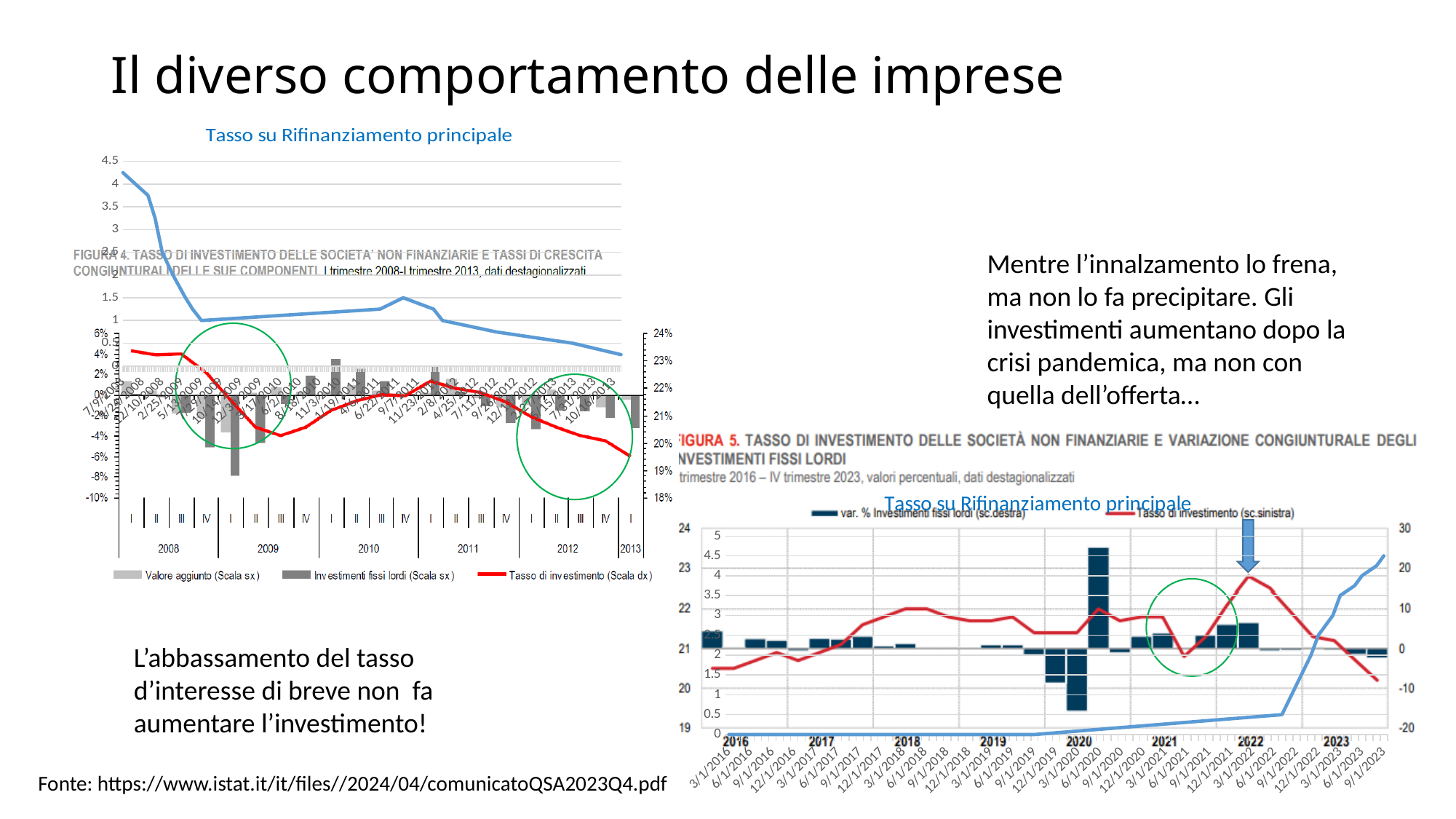
In the left 'Tasso su Rifinanziamento principale' chart, does the blue line overall rise or fall from 2008 to 2013? fall In Figura 4 (left), in which year does the lowest bar for Investimenti fissi lordi occur? 2009 What kind of chart is the left 'Tasso su Rifinanziamento principale' chart? line chart In the left 'Tasso su Rifinanziamento principale' chart, is the value at the start (7/9/2008) greater or less than 4? greater In Figura 5 (right), in which year does the tallest bar for var. % Investimenti fissi lordi occur? 2020 In the right 'Tasso su Rifinanziamento principale' chart (over Figura 5), is the value at 9/1/2023 greater or less than 4? greater How many series does the legend of Figura 5 (right) list? 2 In the right 'Tasso su Rifinanziamento principale' chart (over Figura 5), is the value in 2018 greater or less than 1? less How many series does the legend of Figura 4 (left) list? 3 In Figura 4 (left), what colour is the 'Tasso di investimento (Scala dx)' line? red In the right 'Tasso su Rifinanziamento principale' chart (over Figura 5), does the blue line rise or fall from 2016 to 2023? rise